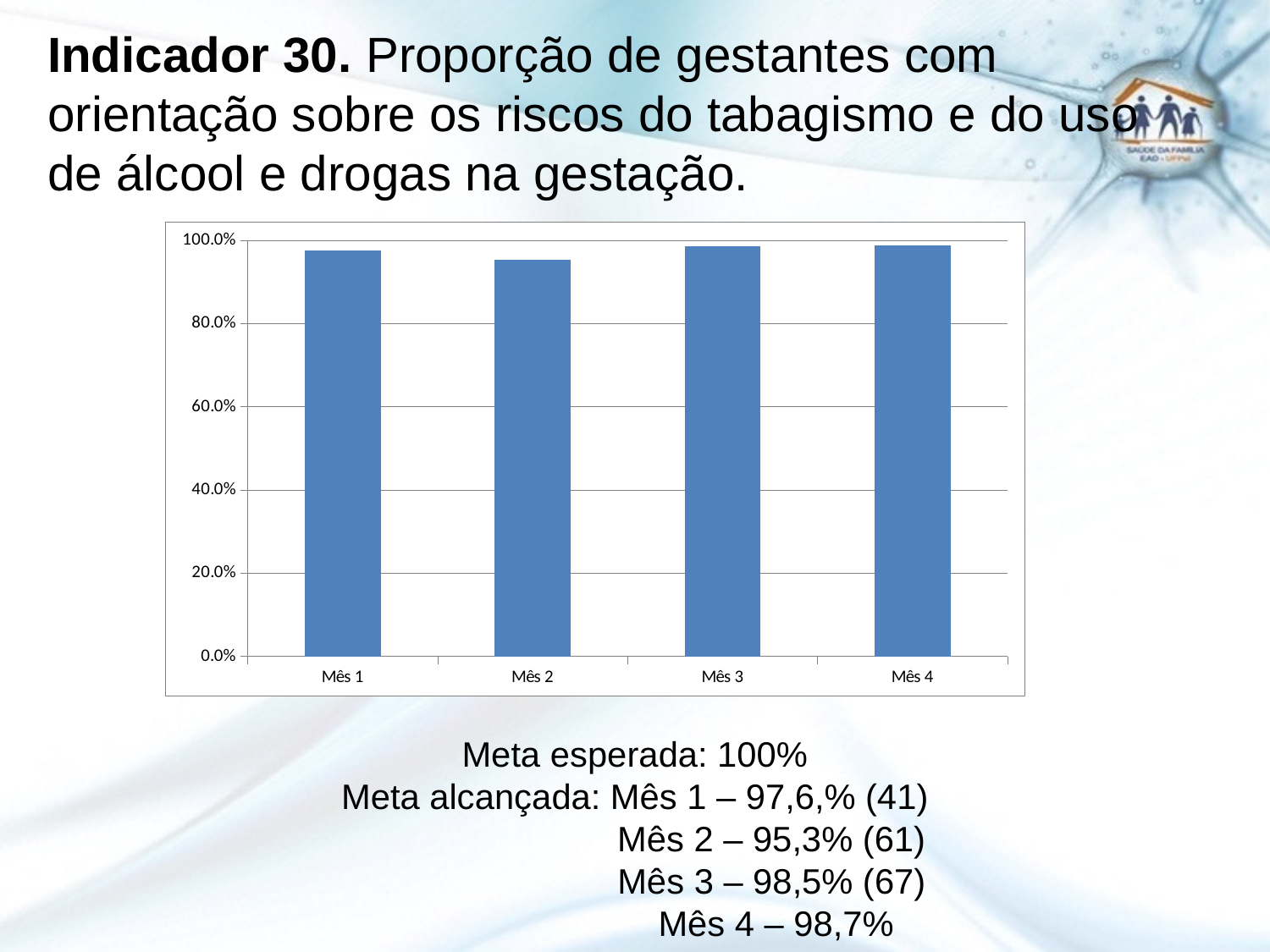
What is the difference in percentage points between the values for Mês 3 and Mês 2 as printed on the slide? 3,2 What is the expected target (Meta esperada) stated on the slide? 100% Which month has the lowest bar in the chart? Mês 2 What kind of chart is shown on the slide? bar chart Is the value for Mês 3 greater or less than 100.0%? less Is the value for Mês 2 greater or less than 80.0%? greater According to the text below the chart, what value was reached in Mês 4? 98,7% What is the highest tick value shown on the vertical axis of the chart? 100.0% Which is larger, the value for Mês 1 or the value for Mês 2? Mês 1 How many categories (months) are plotted in the chart? 4 According to the text below the chart, what value was reached in Mês 3? 98,5% According to the text below the chart, what value was reached in Mês 2? 95,3%